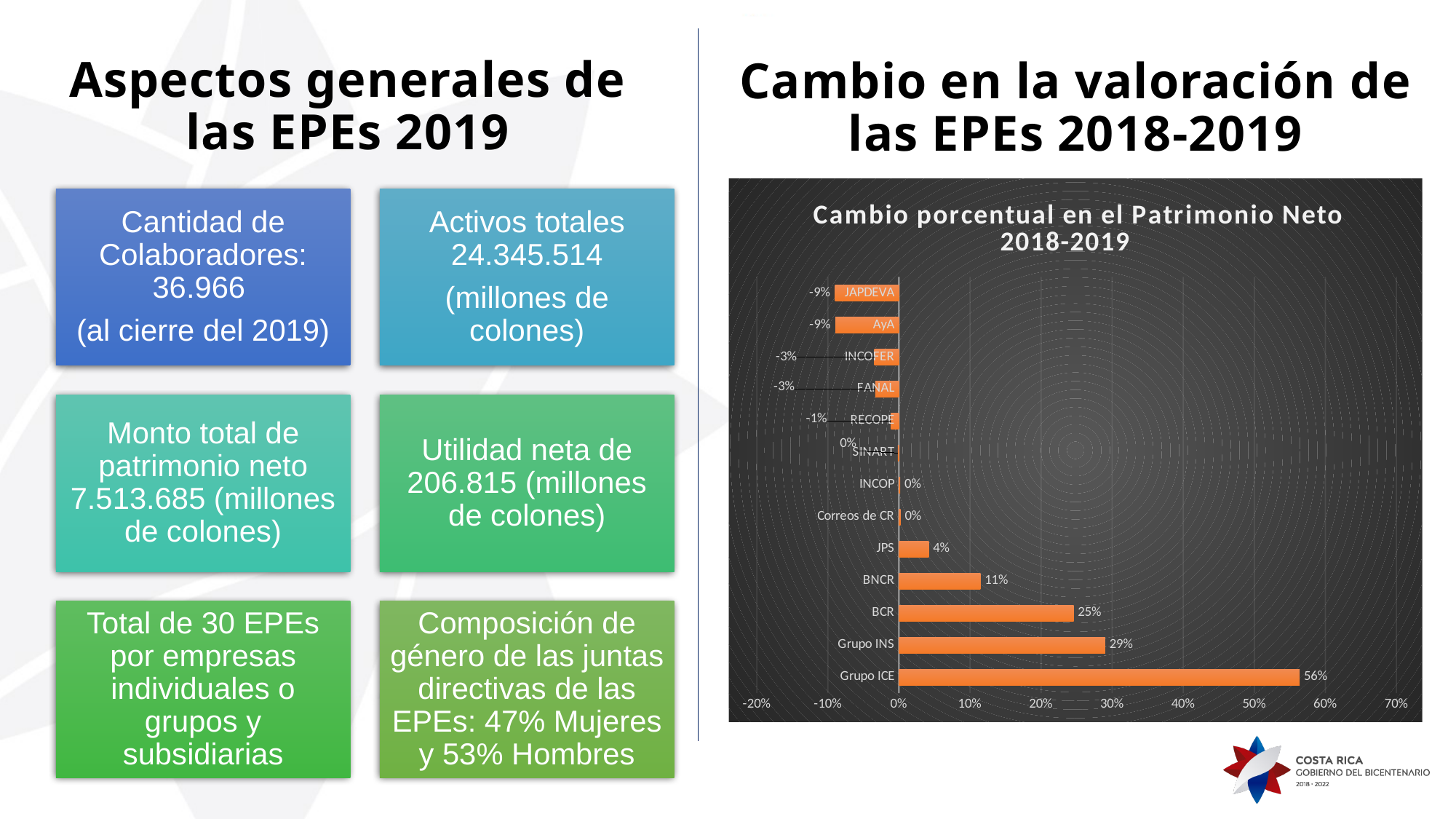
What is the value for Grupo ICE in the chart? 56% What is the difference between the values for Grupo ICE and Grupo INS? 27% What is the value for BNCR in the chart? 11% Which is larger, the value for BCR or the value for JPS? BCR What is the title of the chart? Cambio porcentual en el Patrimonio Neto 2018-2019 Is the value for Grupo INS greater or less than 20%? greater What is the difference between the values for BCR and BNCR? 14% How many categories are shown in the chart? 13 What is the value for RECOPE in the chart? -1% What kind of chart is shown on the slide? Bar chart Which category has the highest value in the chart? Grupo ICE What is the value for JAPDEVA in the chart? -9%